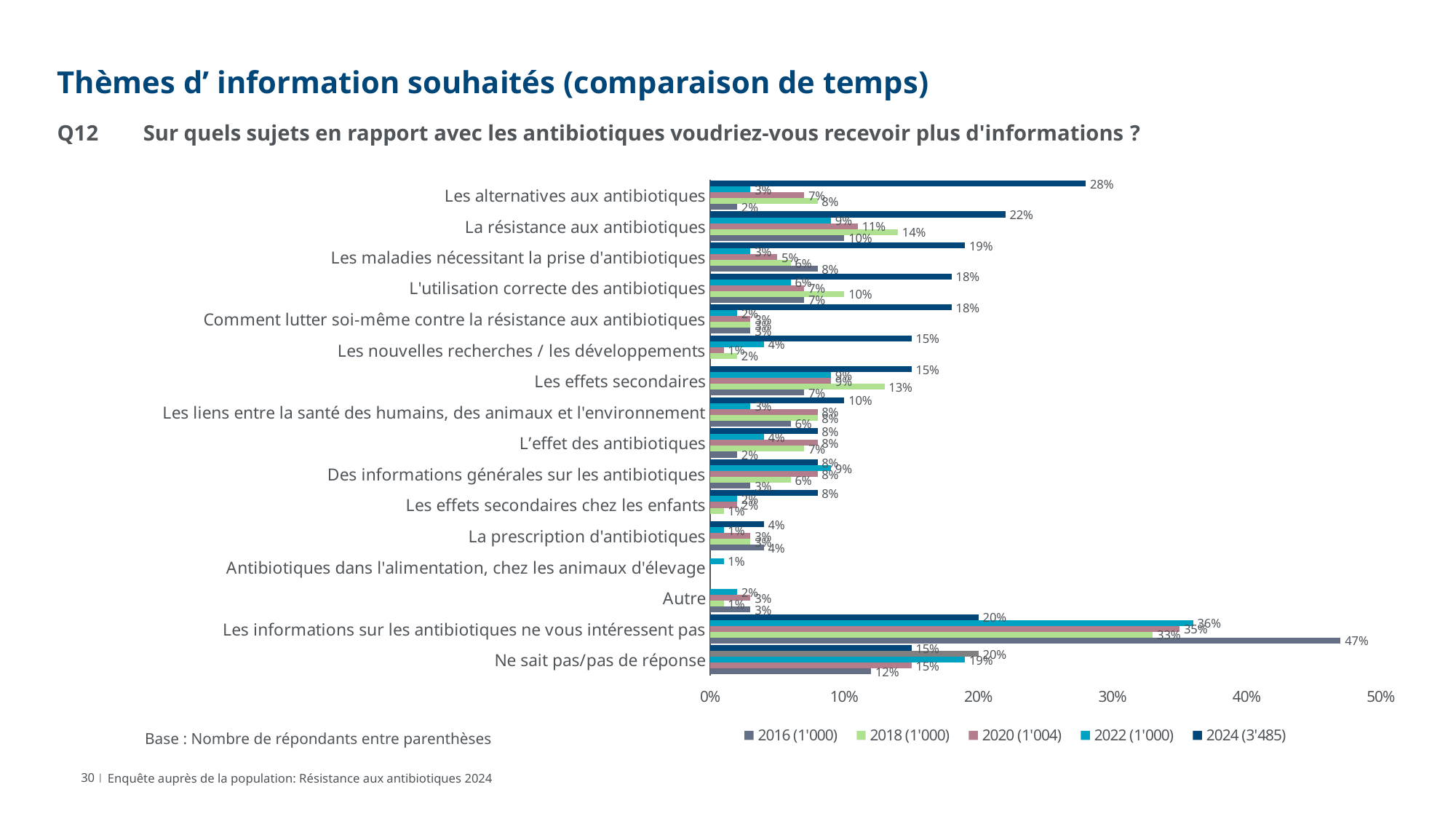
What is the 2018 value for 'La résistance aux antibiotiques'? 14% Is the 2016 value for 'Les informations sur les antibiotiques ne vous intéressent pas' greater or less than 40%? greater According to the legend, how many respondents does the 2024 series have? 3'485 How many series does the legend list? 5 What is the 2024 value for 'Les maladies nécessitant la prise d'antibiotiques'? 19% For 2024, which is larger: 'Les alternatives aux antibiotiques' or 'La résistance aux antibiotiques'? Les alternatives aux antibiotiques What is the 2016 value for 'Les informations sur les antibiotiques ne vous intéressent pas'? 47% How many categories (topics) are listed on the chart? 16 Which topic has the highest 2024 value? Les alternatives aux antibiotiques What is the 2024 value for 'Les alternatives aux antibiotiques'? 28% What is the difference between the 2024 and 2016 values for 'Les alternatives aux antibiotiques'? 26 percentage points What kind of chart is shown on the slide? Bar chart